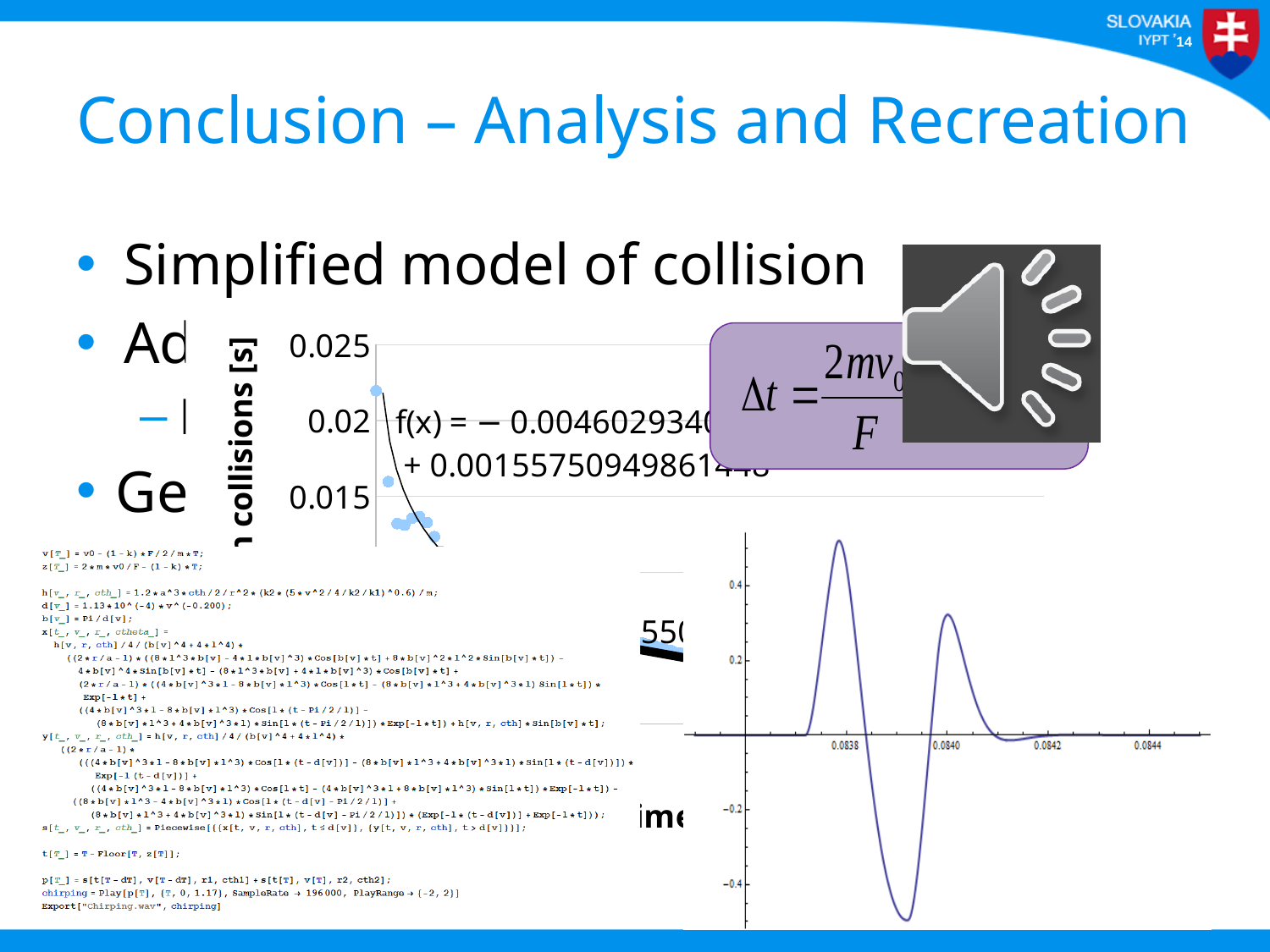
On the line chart in the bottom right of the slide, is the lowest trough of the curve greater or less than -0.4? less What is the lowest y-axis tick value shown on the scatter chart in the upper middle of the slide? 0.015 On the scatter chart in the upper middle of the slide, is the value of the leftmost (highest) data point greater or less than 0.02? greater On the scatter chart in the upper middle of the slide, is the value of the lowest cluster of data points greater or less than 0.015? less What is the smallest labelled x-axis tick value on the line chart in the bottom right of the slide? 0.0838 What kind of chart is the chart in the upper middle of the slide with the y-axis labelled in seconds? scatter chart What is the highest y-axis tick value shown on the scatter chart in the upper middle of the slide? 0.025 What kind of chart is the chart in the bottom right of the slide? line chart How many labelled x-axis tick values are shown on the line chart in the bottom right of the slide? 4